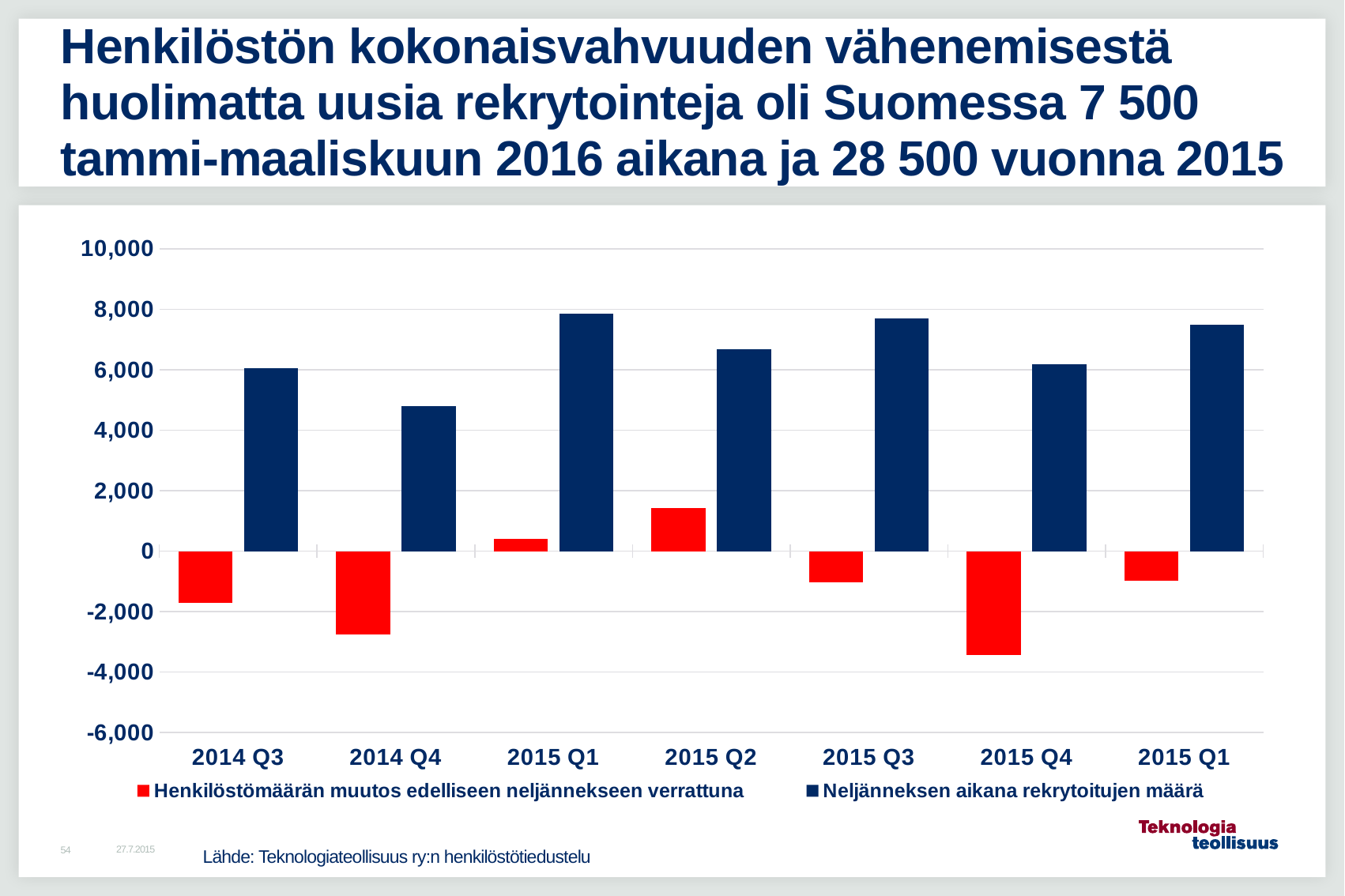
Which is larger, the 'Neljänneksen aikana rekrytoitujen määrä' value for 2014 Q3 or for 2014 Q4? 2014 Q3 Is the value for 'Neljänneksen aikana rekrytoitujen määrä' in 2015 Q2 greater or less than 6,000? greater What kind of chart is shown on the slide? bar chart Which colour represents 'Henkilöstömäärän muutos edelliseen neljännekseen verrattuna' in the legend? red Which quarter has the lowest value for 'Henkilöstömäärän muutos edelliseen neljännekseen verrattuna'? 2015 Q4 How many quarters show a positive value for 'Henkilöstömäärän muutos edelliseen neljännekseen verrattuna'? 2 Is the value for 'Henkilöstömäärän muutos edelliseen neljännekseen verrattuna' in 2015 Q4 greater or less than -2,000? less Which quarter has the highest value for 'Henkilöstömäärän muutos edelliseen neljännekseen verrattuna'? 2015 Q2 How many series does the legend list? 2 How many quarters (categories) are shown on the x axis? 7 Which quarter has the lowest value for 'Neljänneksen aikana rekrytoitujen määrä'? 2014 Q4 Is the value for 'Neljänneksen aikana rekrytoitujen määrä' in 2014 Q4 greater or less than 6,000? less